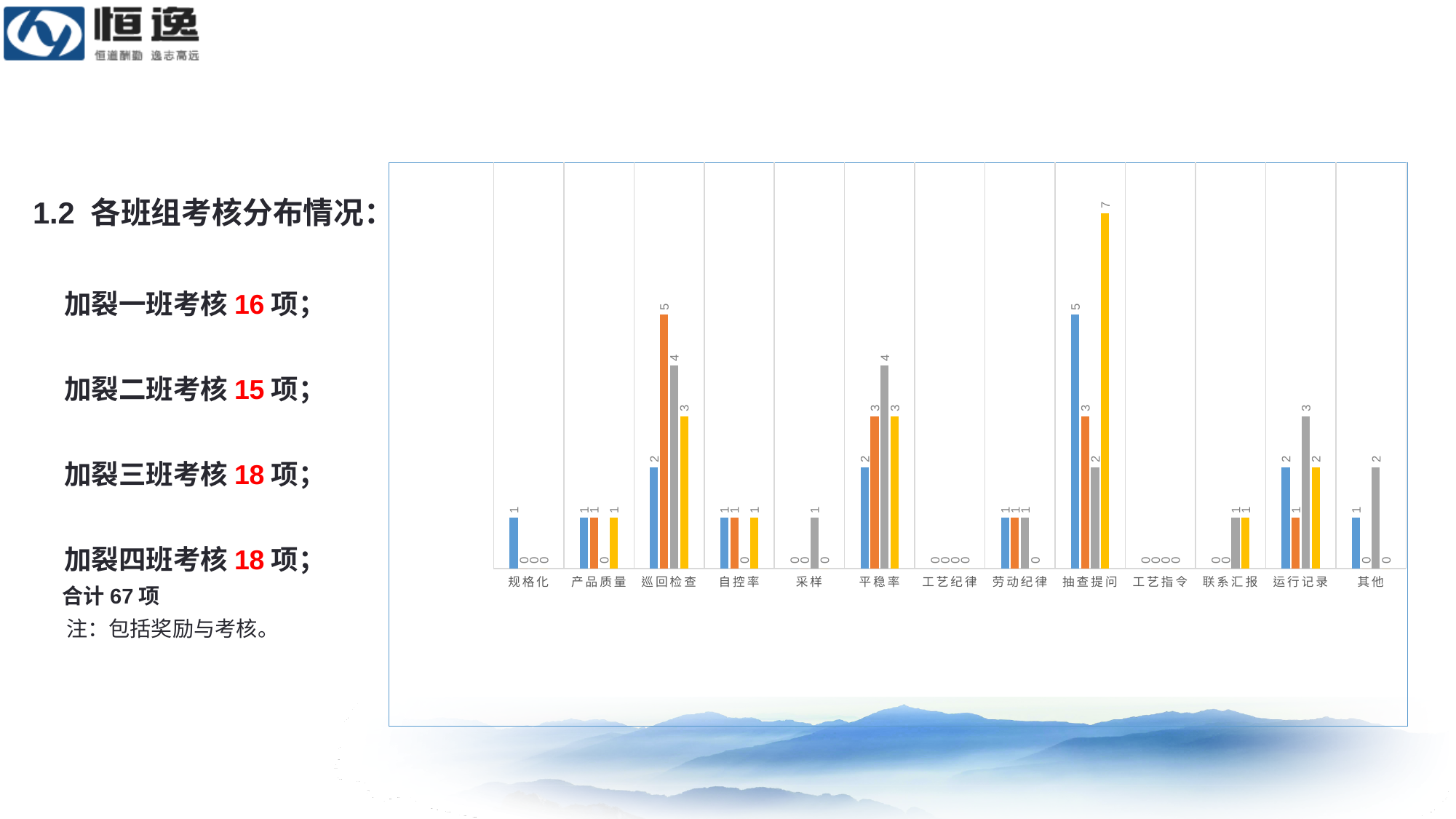
What is the value of the orange bar for 巡回检查? 5 How many categories are shown along the x axis of the chart? 13 What is the difference between the yellow bar and the blue bar for 抽查提问? 2 What is the value of the blue bar for 抽查提问? 5 Which is larger for 巡回检查: the orange bar or the gray bar? the orange bar What is the value of the gray bar for 其他? 2 What is the value of the gray bar for 运行记录? 3 What is the value of the yellow bar for 抽查提问? 7 Which category has the tallest bar in the chart? 抽查提问 What is the total of the four bars for 巡回检查? 14 What is the value of the gray bar for 平稳率? 4 What type of chart is shown on the slide? bar chart